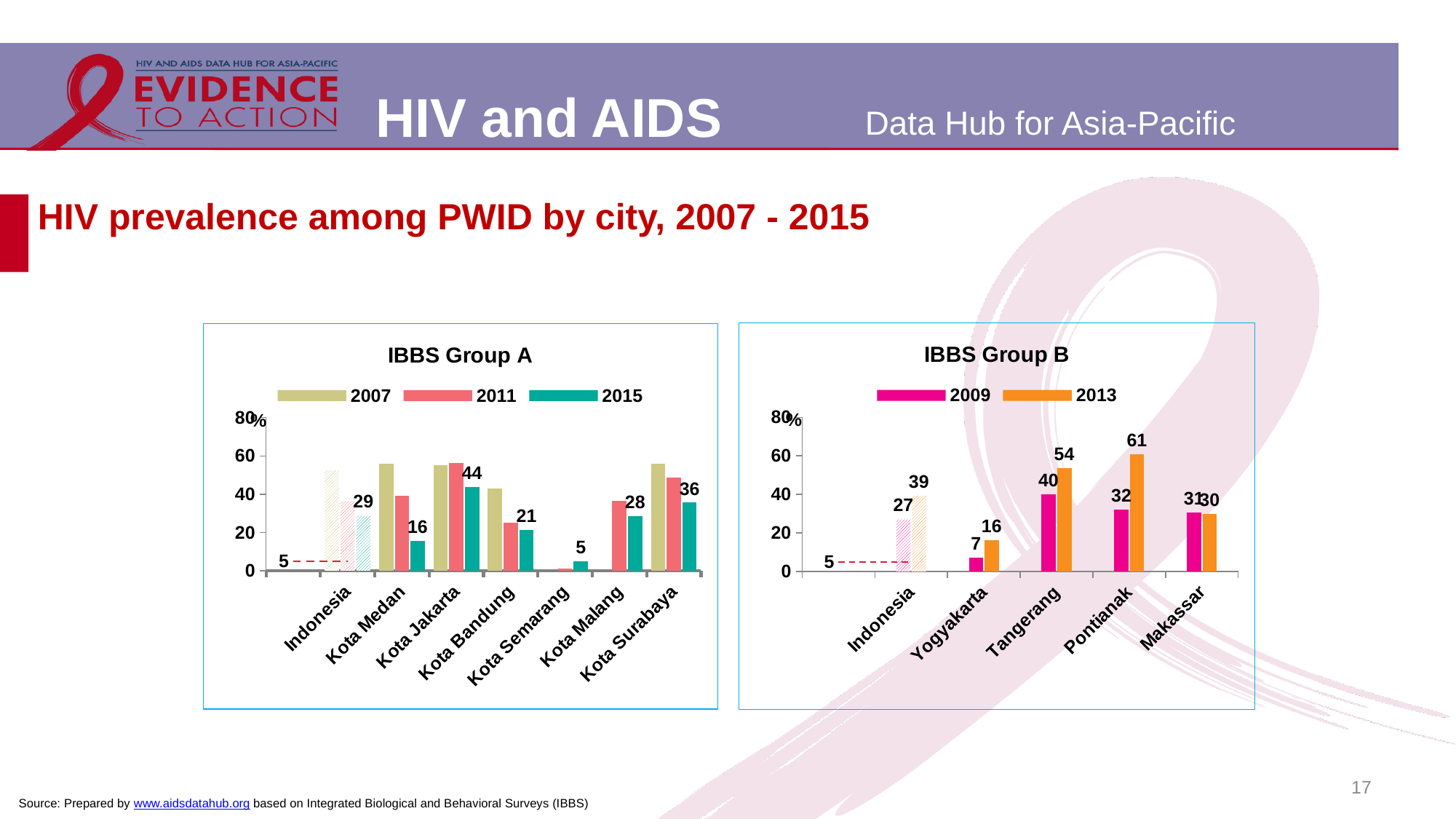
On the IBBS Group B chart, what is the difference between the 2013 and 2009 values for Pontianak? 29 On the IBBS Group A chart, how many series does the legend list? 3 On the IBBS Group A chart, which city has the lowest 2015 value? Kota Semarang On the IBBS Group A chart, what is the difference between the 2015 values for Kota Surabaya and Kota Malang? 8 On the IBBS Group B chart, which is larger for Makassar, the 2009 value or the 2013 value? 2009 On the IBBS Group A chart, is the 2007 value for Kota Medan greater or less than 40? greater On the IBBS Group B chart, what is the 2013 value for Pontianak? 61 On the IBBS Group A chart, what kind of chart is shown? bar chart On the IBBS Group A chart, which category has the highest 2015 value? Kota Jakarta On the IBBS Group B chart, which category has the highest 2013 value? Pontianak On the IBBS Group A chart, how many cities/categories are shown on the x axis? 7 On the IBBS Group A chart, what is the 2015 value for Kota Jakarta? 44